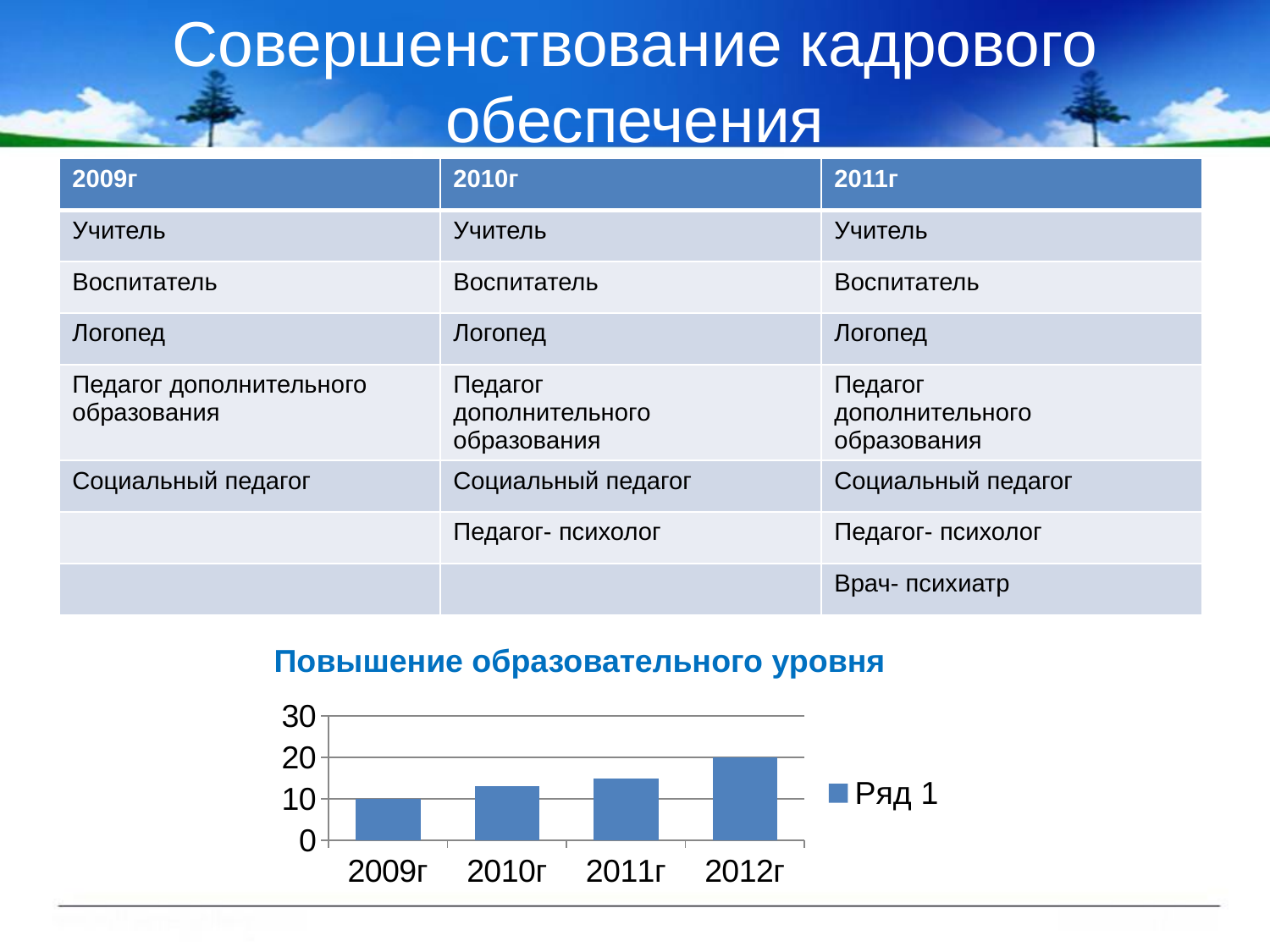
Do the values in the chart rise or fall from 2009г to 2012г? rise Is the value for 2011г greater or less than 20? less What kind of chart is shown on the slide? bar chart Which year has the lowest bar in the chart? 2009г Is the value for 2009г greater or less than 20? less Is the value for 2010г greater or less than 10? greater How many series does the chart legend list? 1 How many categories are shown on the x axis of the chart? 4 Which is larger in the chart, the value for 2010г or the value for 2012г? 2012г What is the title of the chart on the slide? Повышение образовательного уровня What is the name of the series in the chart legend? Ряд 1 Which year has the highest bar in the chart? 2012г